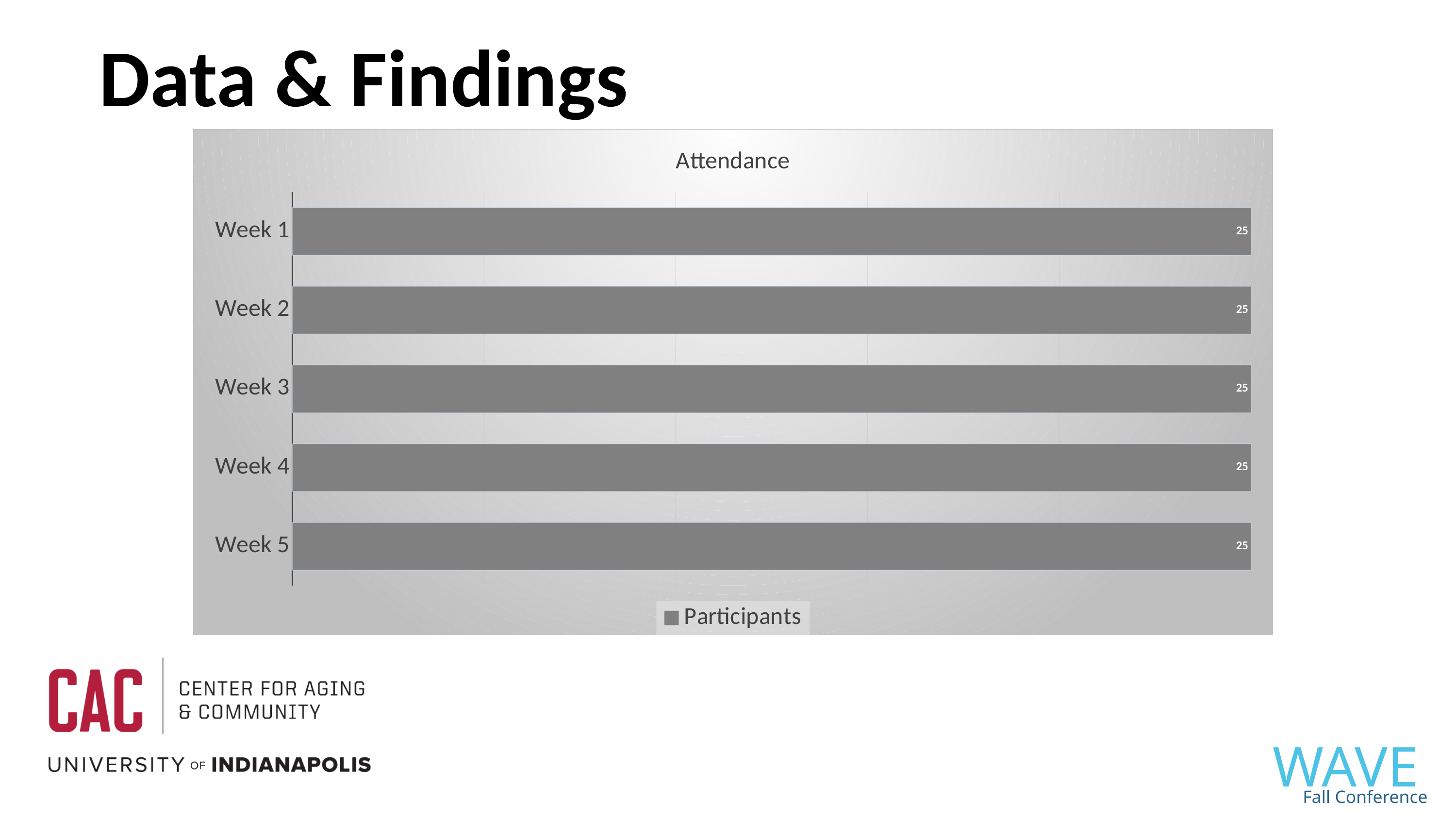
How many categories (weeks) are shown in the Attendance chart? 5 What is the title of the chart? Attendance What kind of chart is shown on the slide? bar chart What is the value for Week 5 in the Attendance chart? 25 What is the name of the series listed in the legend? Participants What is the difference between the values for Week 2 and Week 4? 0 How many series does the legend list? 1 What is the value for Week 3 in the Attendance chart? 25 What is the value for Week 1 in the Attendance chart? 25 Do the values rise, fall, or stay the same from Week 1 to Week 5? stay the same What is the total of the values for Week 1 and Week 2? 50